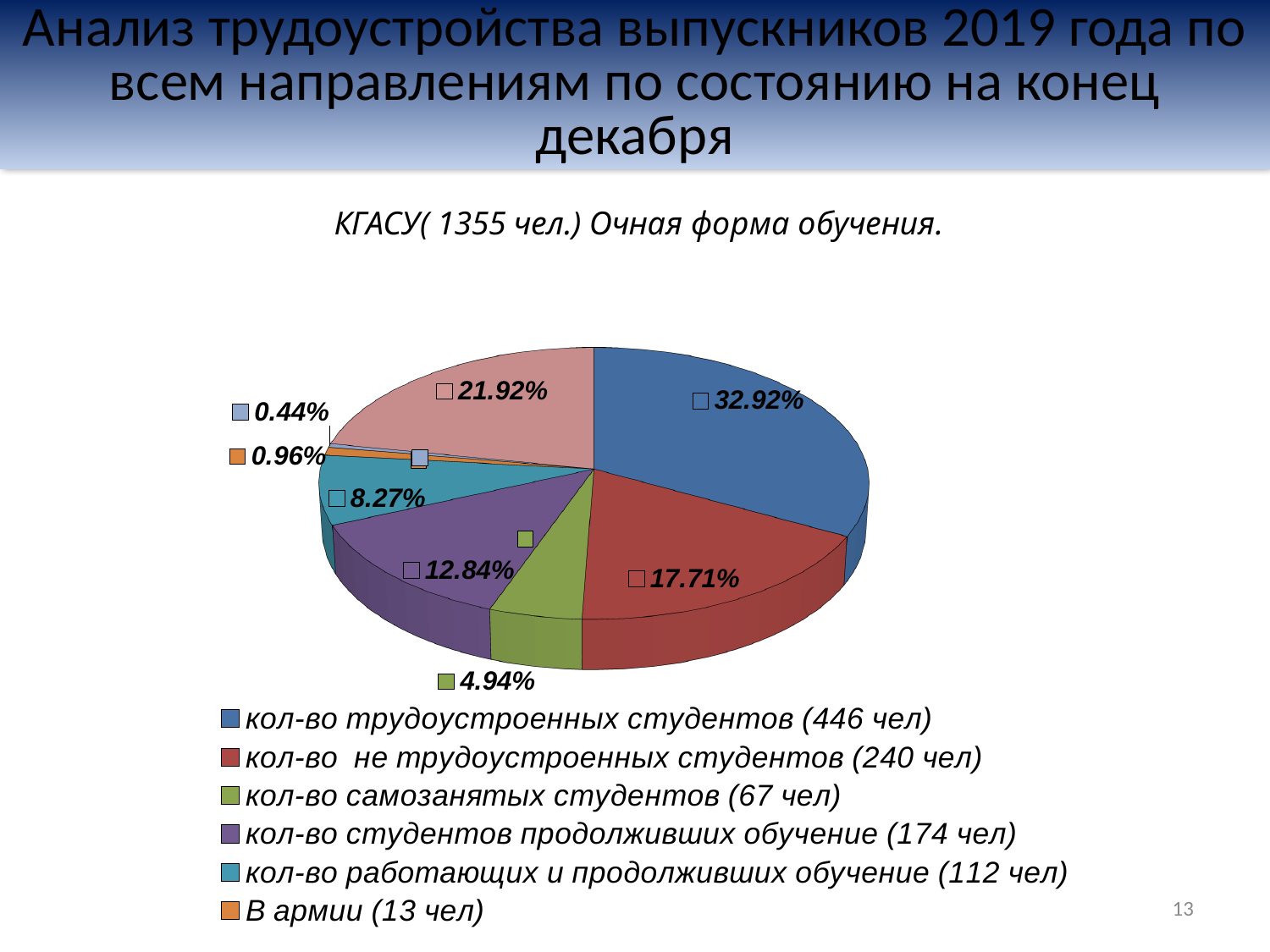
What is the smallest percentage shown on the pie chart? 0.44% What percentage of the pie corresponds to 'кол-во студентов продолживших обучение'? 12.84% What percentage of the pie corresponds to 'кол-во работающих и продолживших обучение'? 8.27% What percentage of the pie corresponds to 'кол-во трудоустроенных студентов'? 32.92% What is the difference in percentage points between 'кол-во трудоустроенных студентов' and 'кол-во не трудоустроенных студентов'? 15.21% What percentage of the pie corresponds to 'кол-во самозанятых студентов'? 4.94% What percentage of the pie corresponds to 'кол-во не трудоустроенных студентов'? 17.71% Which category has the largest share of the pie? кол-во трудоустроенных студентов (446 чел) How many slices does the pie chart have? 8 What kind of chart is shown on the slide? pie chart Which share is larger: 'кол-во студентов продолживших обучение' or 'кол-во работающих и продолживших обучение'? кол-во студентов продолживших обучение What percentage of the pie corresponds to 'В армии'? 0.96%